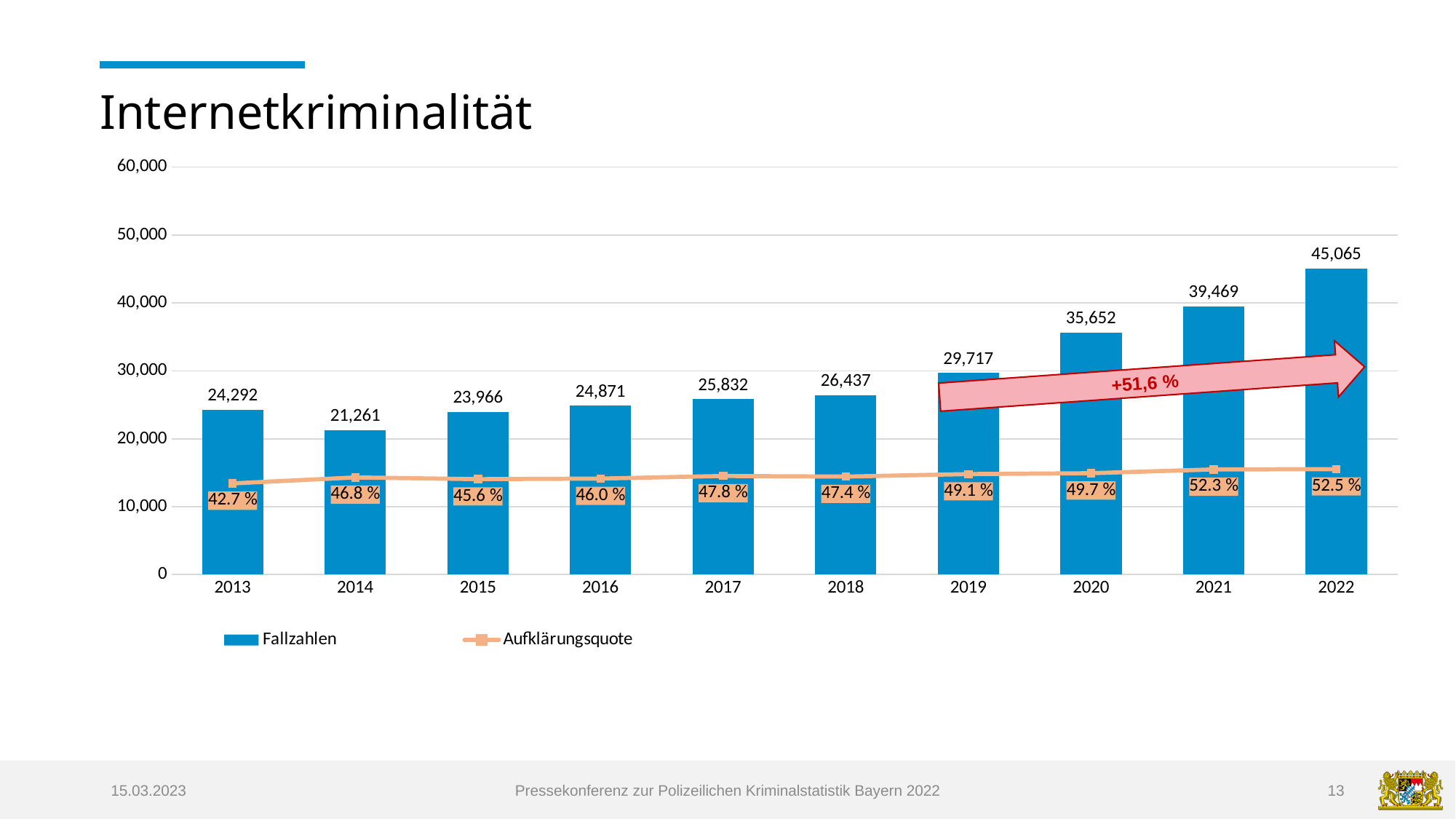
What is the Aufklärungsquote for 2013? 42.7 % What kind of chart is used for the Fallzahlen series? bar chart How many series does the legend list? 2 Which year has the larger Fallzahlen, 2017 or 2018? 2018 Which year has the lowest Fallzahlen? 2014 Which year has the highest Fallzahlen? 2022 How many years are shown on the x axis? 10 What is the difference in Fallzahlen between 2022 and 2021? 5,596 What is the Fallzahlen value for 2022? 45,065 Do the Fallzahlen values rise or fall from 2019 to 2022? rise Is the Fallzahlen value for 2020 greater or less than 30,000? greater Which year has the lowest Aufklärungsquote? 2013